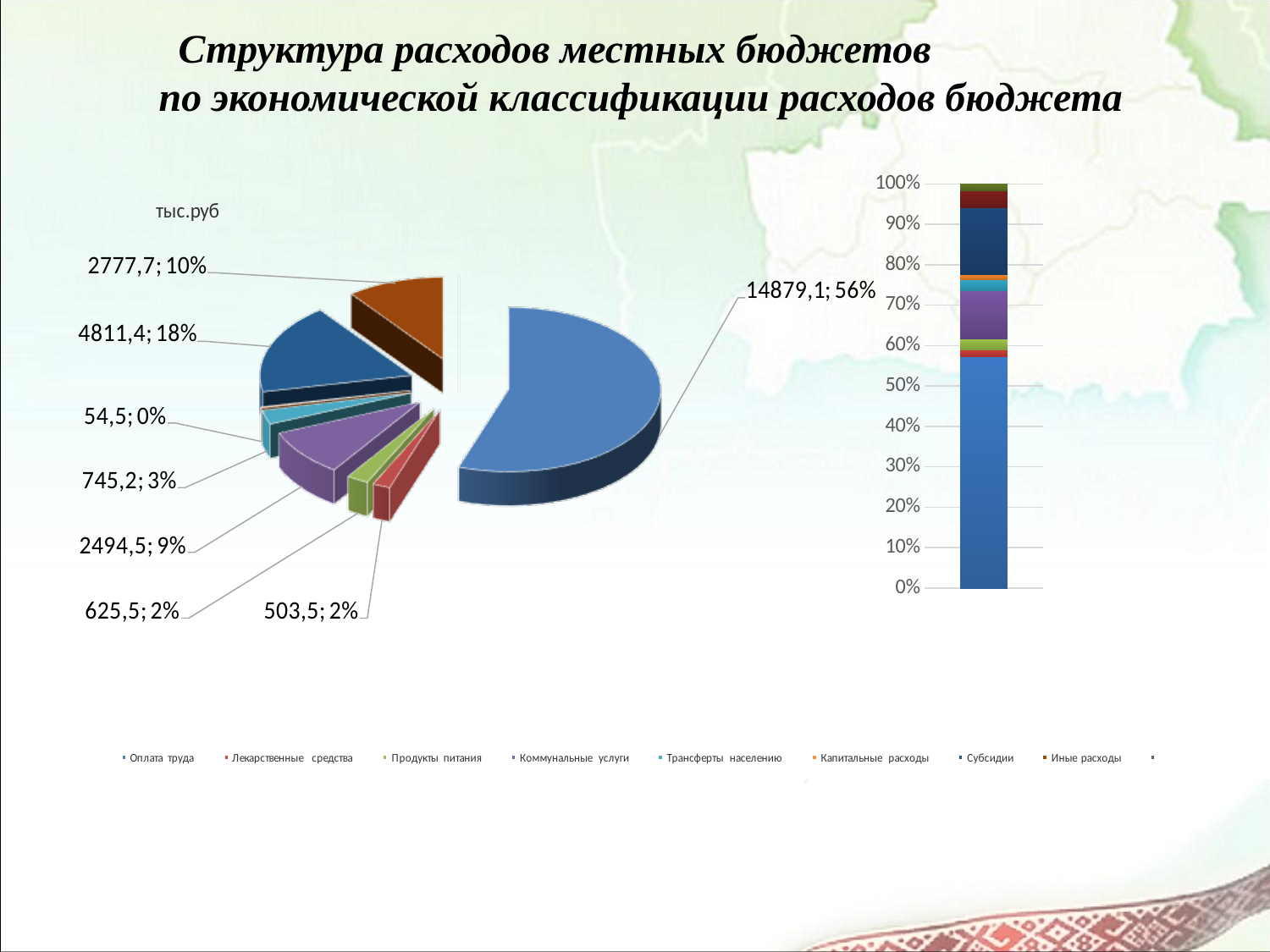
In the pie chart, what share of the total does the largest slice represent? 56% In the pie chart, which is larger: the slice valued 625,5 or the slice valued 503,5? 625,5 What unit label is shown above the pie chart? тыс.руб In the pie chart, what percentage is shown for the slice with value 2494,5? 9% What kind of chart is shown on the left side of the slide? pie chart In the pie chart, what is the value of the largest slice? 14879,1 In the pie chart, what is the difference between the slice valued 4811,4 and the slice valued 2777,7? 2033,7 In the pie chart, what is the value of the smallest slice? 54,5 In the pie chart, what is the value of the slice labelled 18%? 4811,4 What kind of chart is shown on the right side of the slide? bar chart In the stacked bar chart on the right, is the top of the bottom blue segment greater or less than 50%? greater